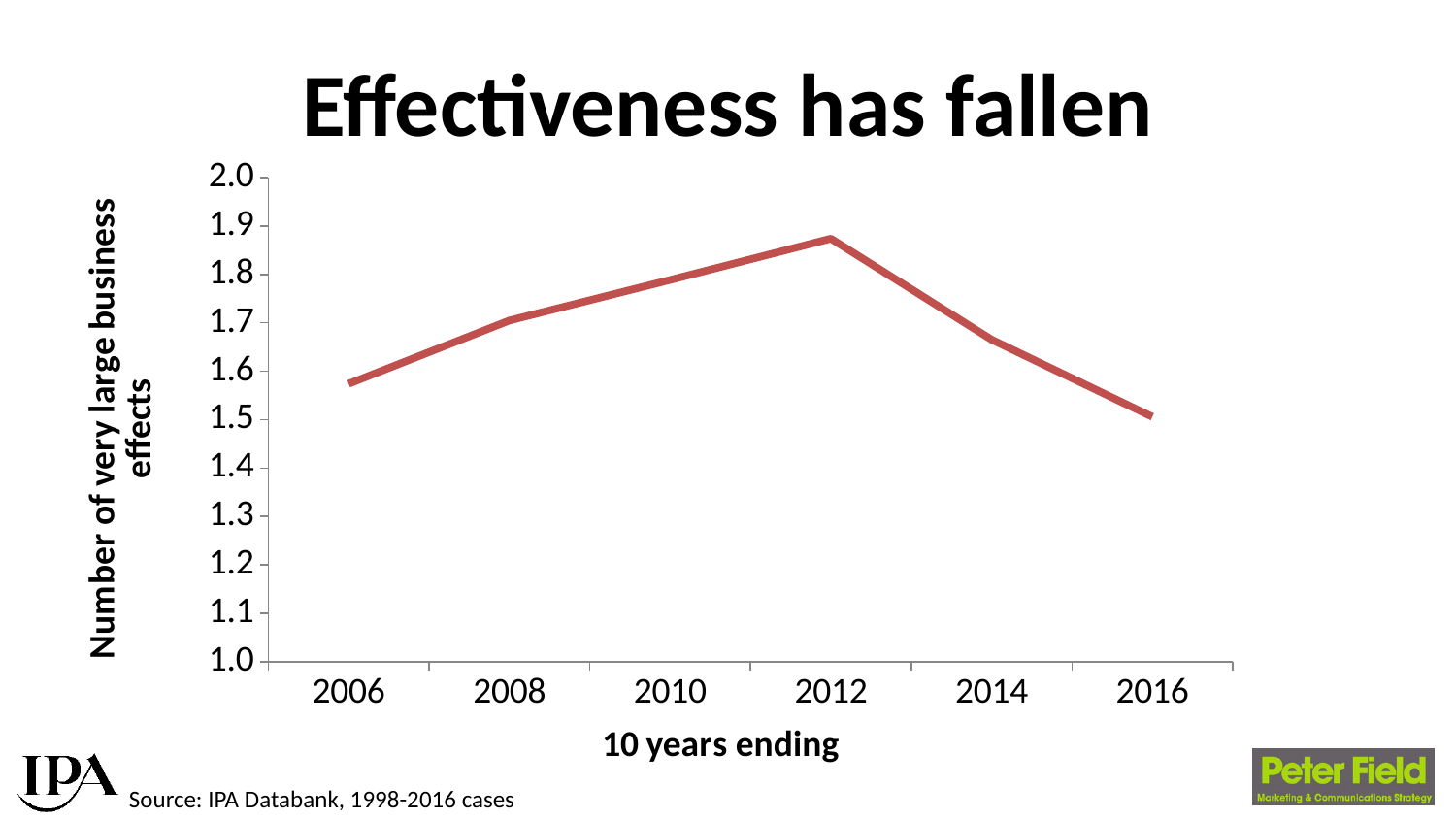
Is the value for 2016 greater or less than 1.6? less Is the value for 2012 greater or less than 1.8? greater How does the line move from 2012 to 2016? It falls Is the value for 2006 greater or less than 1.5? greater What kind of chart is shown on the slide? line chart Which year has the lowest number of very large business effects? 2016 Which year has the highest number of very large business effects? 2012 What is the title of the chart? Effectiveness has fallen How many years are plotted on the x axis? 6 Which is larger, the value for 2010 or the value for 2014? 2010